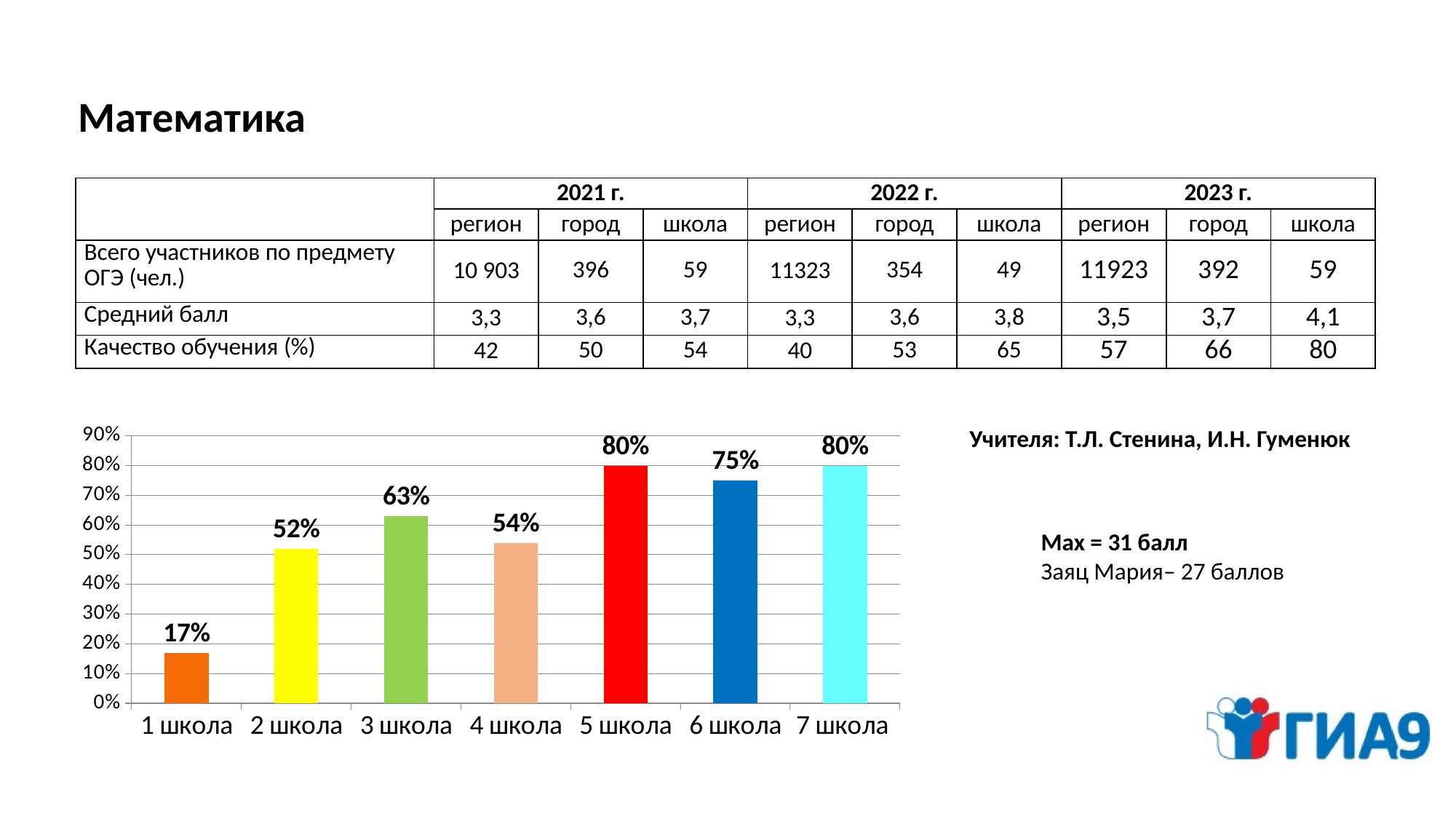
How many schools are shown on the chart? 7 Is the value for 3 школа greater or less than 60%? greater Which is larger, the value for 3 школа or the value for 4 школа? 3 школа Which school has the lowest value? 1 школа What is the difference between the values for 5 школа and 1 школа? 63% What is the value for 4 школа? 54% What kind of chart is shown on the slide? bar chart What colour is the bar for 5 школа? red What is the difference between the values for 3 школа and 4 школа? 9% What is the value for 6 школа? 75% What is the value for 2 школа? 52% Which is larger, the value for 6 школа or the value for 7 школа? 7 школа